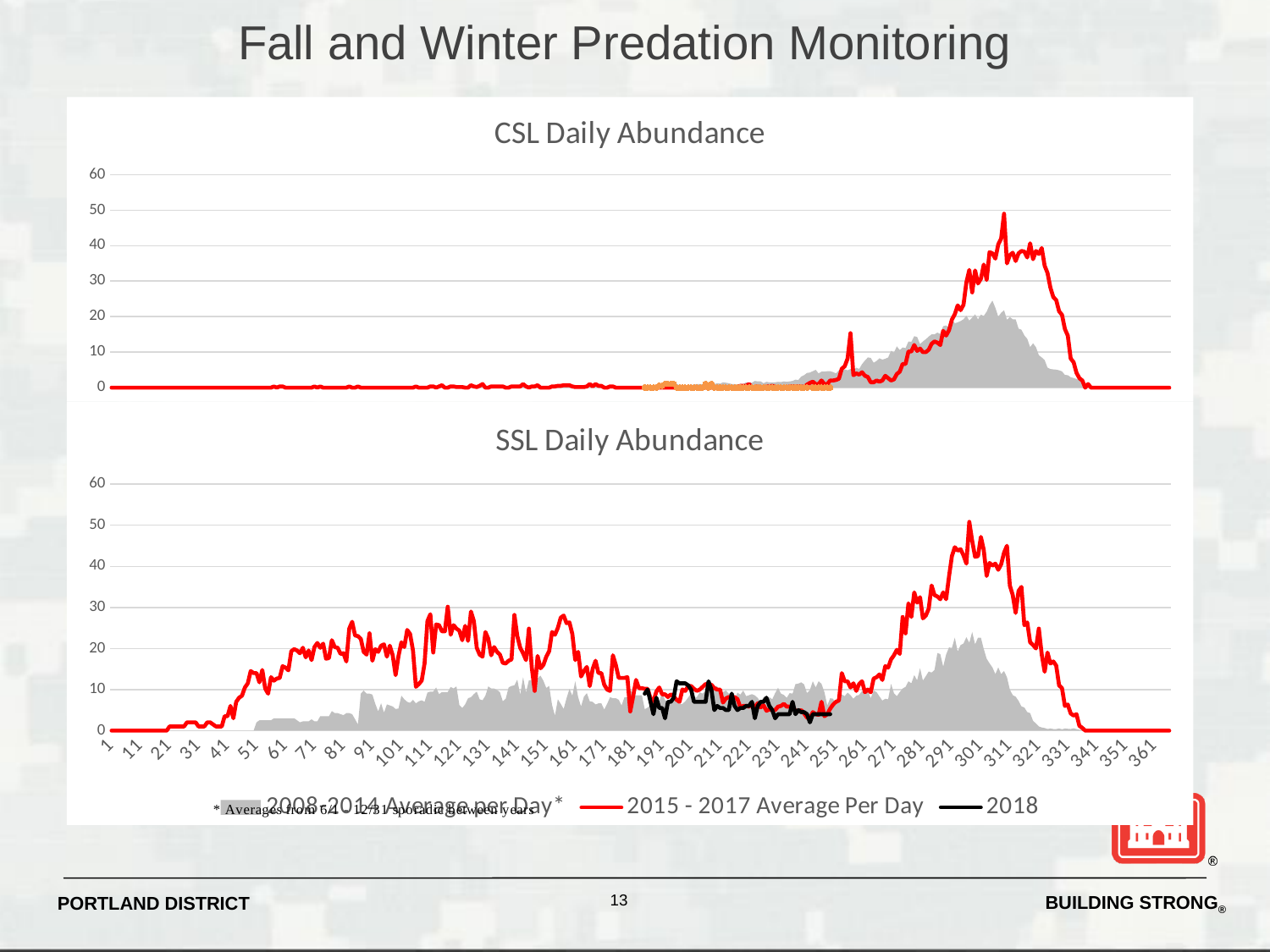
In the CSL Daily Abundance chart, does the 2015 - 2017 Average Per Day line rise or fall between day 281 and day 301? rise What kind of chart is the SSL Daily Abundance chart? line chart What is the title of the bottom chart on the slide? SSL Daily Abundance How many series does the shared legend list for the charts? 3 In the SSL Daily Abundance chart, is the 2018 line ever greater than 20? no In the SSL Daily Abundance chart, which series reaches a higher peak: 2015 - 2017 Average Per Day or 2008-2014 Average per Day? 2015 - 2017 Average Per Day In the CSL Daily Abundance chart, is the peak value of the 2015 - 2017 Average Per Day line greater or less than 40? greater In the CSL Daily Abundance chart, is the peak of the 2008-2014 Average per Day area greater or less than 30? less What is the title of the top chart on the slide? CSL Daily Abundance In the CSL Daily Abundance chart, which series reaches a higher peak: 2015 - 2017 Average Per Day or 2008-2014 Average per Day? 2015 - 2017 Average Per Day